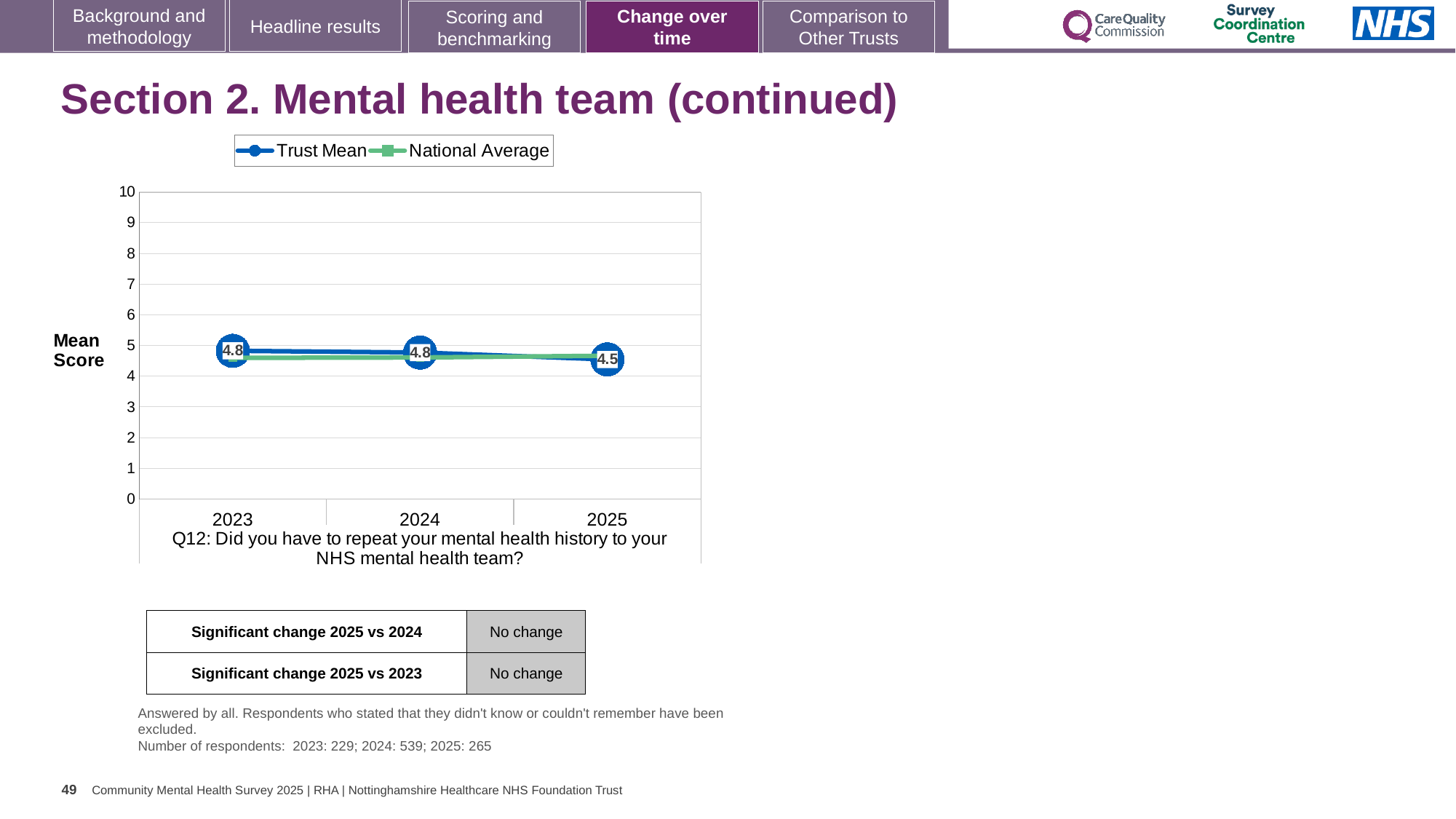
What is the label on the y axis of the chart? Mean Score What kind of chart is shown on the slide? line chart In which year is the Trust Mean lowest? 2025 What is the Trust Mean value for 2024? 4.8 How many series does the legend list? 2 How many years are plotted on the x axis? 3 Is the National Average value for 2025 greater or less than 5? less What is the Trust Mean value for 2023? 4.8 What is the Trust Mean value for 2025? 4.5 Which is larger, the Trust Mean for 2024 or for 2025? 2024 What is the difference between the Trust Mean in 2023 and in 2025? 0.3 Does the Trust Mean rise or fall from 2023 to 2025? fall